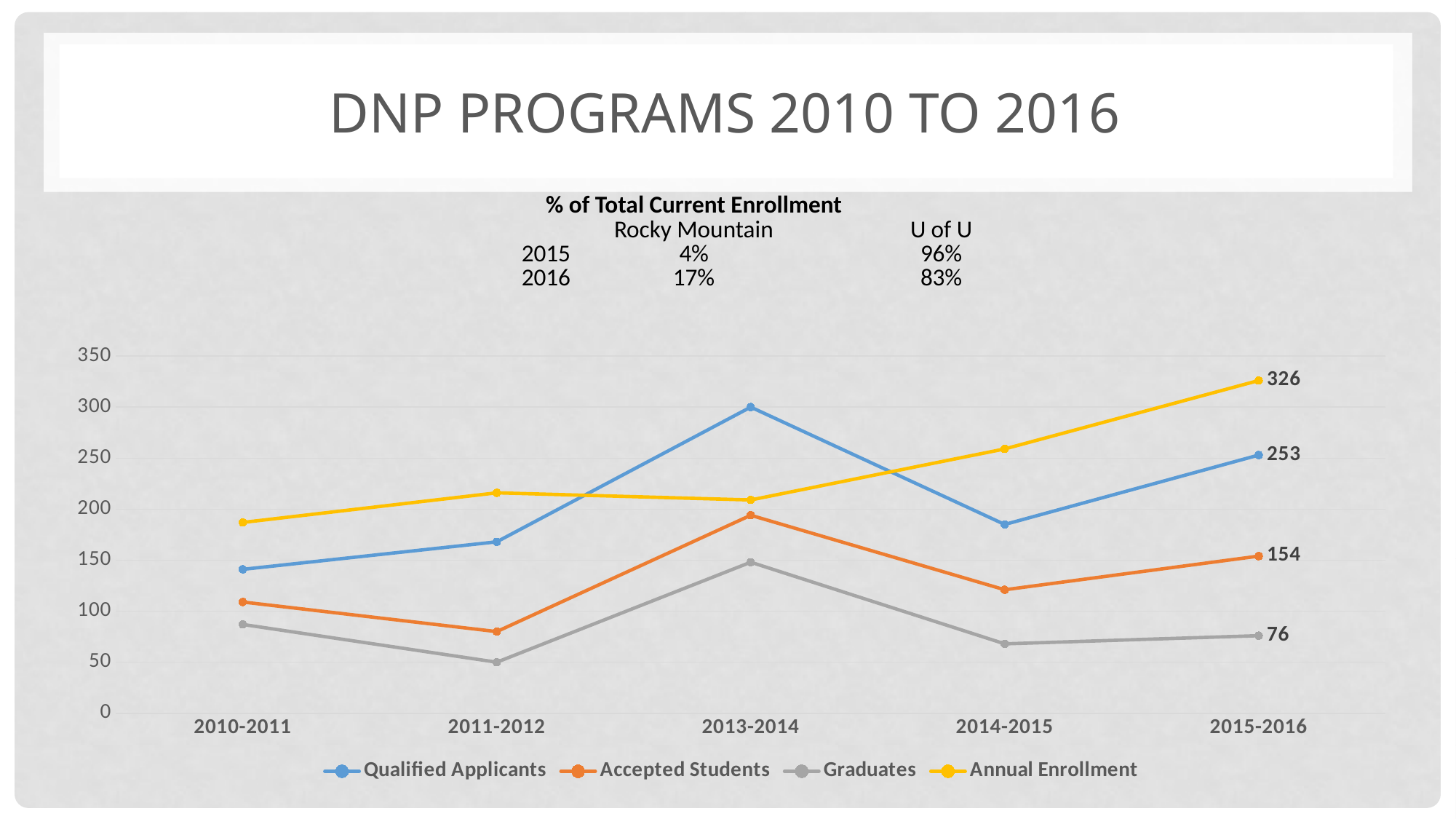
How many series does the legend list? 4 What is the difference between Accepted Students and Graduates in 2015-2016? 78 What is the difference between Annual Enrollment and Qualified Applicants in 2015-2016? 73 What kind of chart is shown on the slide? line chart What is the value for Annual Enrollment in 2015-2016? 326 What is the value for Qualified Applicants in 2015-2016? 253 In which year is Annual Enrollment highest? 2015-2016 How many year categories are shown on the x axis? 5 What is the value for Graduates in 2015-2016? 76 In 2013-2014, which is larger: Qualified Applicants or Annual Enrollment? Qualified Applicants Is the value for Graduates in 2011-2012 greater or less than 100? less Is the value for Qualified Applicants in 2013-2014 greater or less than 250? greater